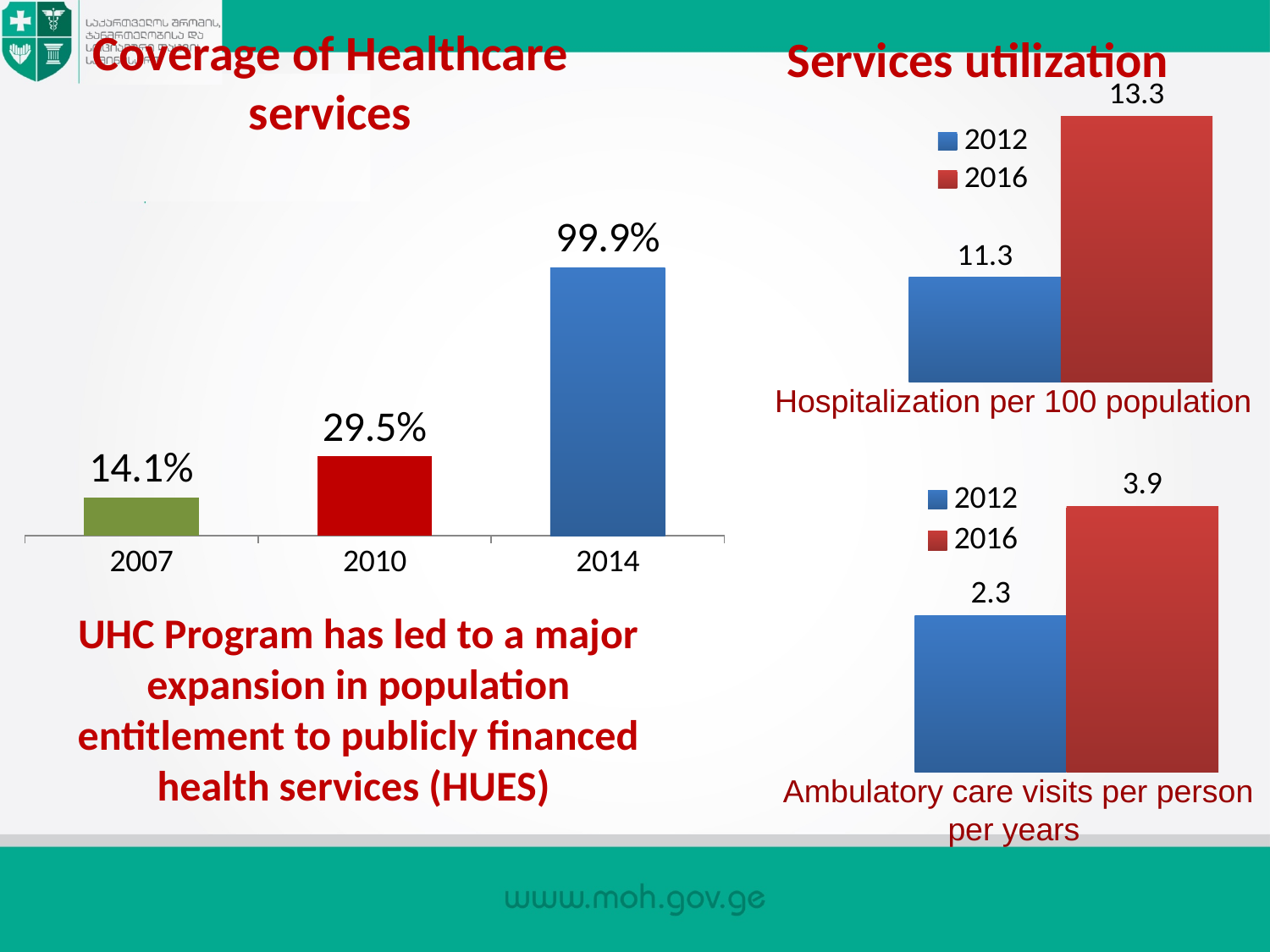
In the Coverage of Healthcare services chart, what is the value for 2007? 14.1% In the Coverage of Healthcare services chart, what is the difference between the 2010 and 2007 values? 15.4% In the Ambulatory care visits per person per years chart, what is the value for 2012? 2.3 In the Coverage of Healthcare services chart, how many years are shown on the x axis? 3 In the Hospitalization per 100 population chart, how many series does the legend list? 2 In the Hospitalization per 100 population chart, what is the difference between the 2016 and 2012 values? 2.0 What type of chart is the Ambulatory care visits per person per years chart? bar chart In the Coverage of Healthcare services chart, do the values rise or fall from 2007 to 2014? rise In the Hospitalization per 100 population chart, what is the value for 2016? 13.3 In the Coverage of Healthcare services chart, what is the value for 2014? 99.9% In the Coverage of Healthcare services chart, which year has the lowest value? 2007 In the Ambulatory care visits per person per years chart, which year has the higher value, 2012 or 2016? 2016